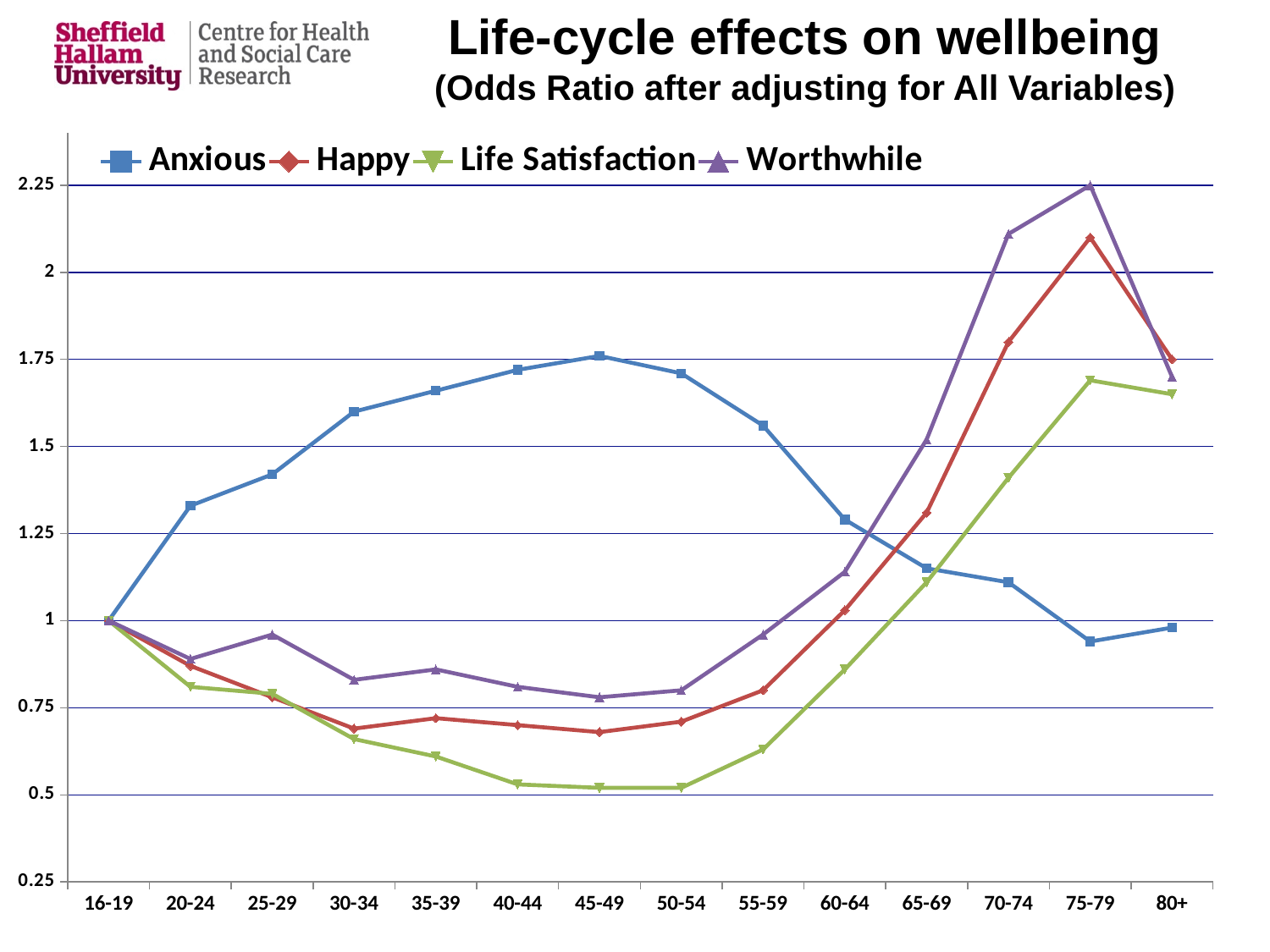
How many age groups are shown along the x axis? 14 Is the value for Worthwhile at 70-74 greater or less than 2? greater Is the value for Anxious at 30-34 greater or less than 1.5? greater Does the Anxious series rise or fall from 16-19 to 45-49? rise What is the subtitle shown under the chart title? (Odds Ratio after adjusting for All Variables) At age group 60-64, which is larger: Anxious or Happy? Anxious At which age group does the Worthwhile series reach its highest value? 75-79 Is the value for Life Satisfaction at 45-49 greater or less than 0.75? less How many series does the legend list? 4 What is the value for Anxious at age group 16-19? 1 What kind of chart is shown on the slide? line chart At which age group does the Anxious series reach its highest value? 45-49